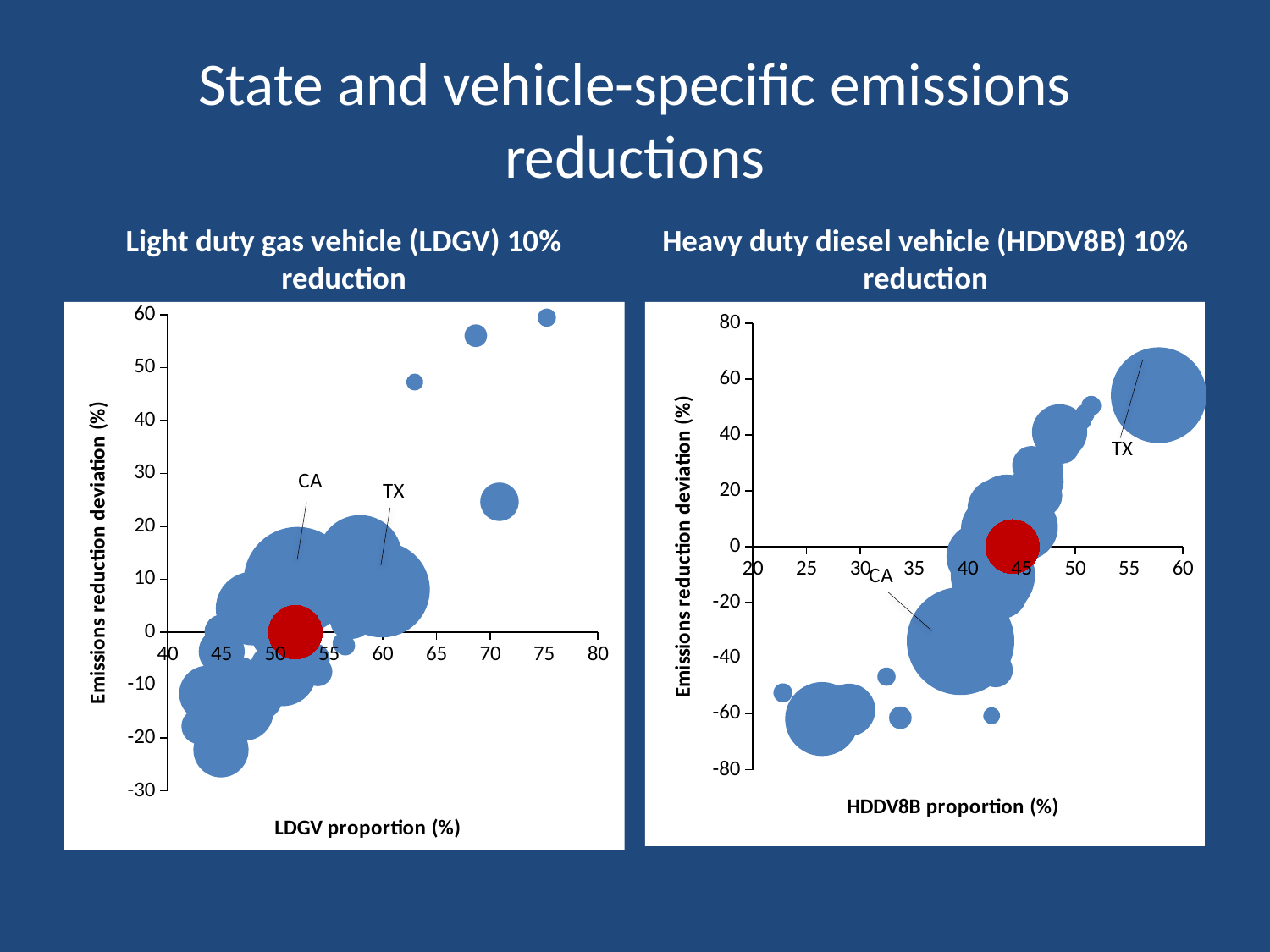
In the right chart (HDDV8B 10% reduction), which labeled state has the higher emissions reduction deviation, CA or TX? TX What type of chart is the left chart titled 'Light duty gas vehicle (LDGV) 10% reduction'? Bubble chart In the right chart (HDDV8B 10% reduction), is the emissions reduction deviation for CA greater or less than 0? less In the right chart (HDDV8B 10% reduction), is the emissions reduction deviation for TX greater or less than 40? greater In the right chart (HDDV8B 10% reduction), is the HDDV8B proportion for TX greater or less than 50? greater What is the y-axis title of the right chart (HDDV8B 10% reduction)? Emissions reduction deviation (%) What is the x-axis title of the left chart (LDGV 10% reduction)? LDGV proportion (%) What type of chart is the right chart titled 'Heavy duty diesel vehicle (HDDV8B) 10% reduction'? Bubble chart